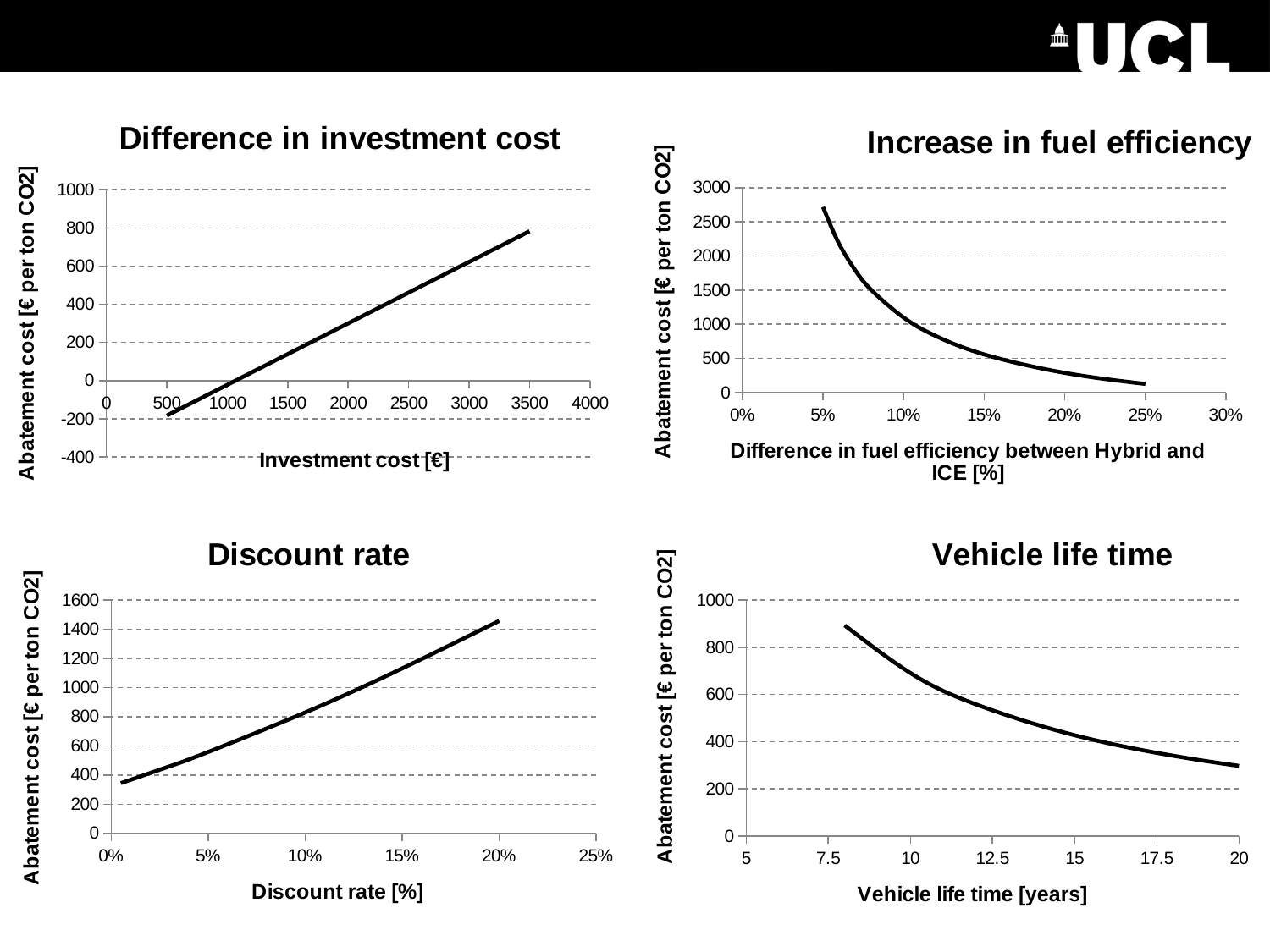
In the "Discount rate" chart, does the abatement cost rise or fall as the discount rate increases? rise In the "Increase in fuel efficiency" chart, does the abatement cost rise or fall as the difference in fuel efficiency increases? fall In the "Discount rate" chart, is the abatement cost at a 20% discount rate greater or less than 1200? greater In the "Vehicle life time" chart, does the abatement cost rise or fall as vehicle life time increases? fall What is the x-axis title of the "Vehicle life time" chart? Vehicle life time [years] In the "Difference in investment cost" chart, is the abatement cost at an investment cost of 500 greater or less than 0? less In the "Increase in fuel efficiency" chart, is the abatement cost at a 5% fuel efficiency difference greater or less than 2000? greater How many charts are shown on the slide? 4 What kind of chart is the "Difference in investment cost" chart? line chart